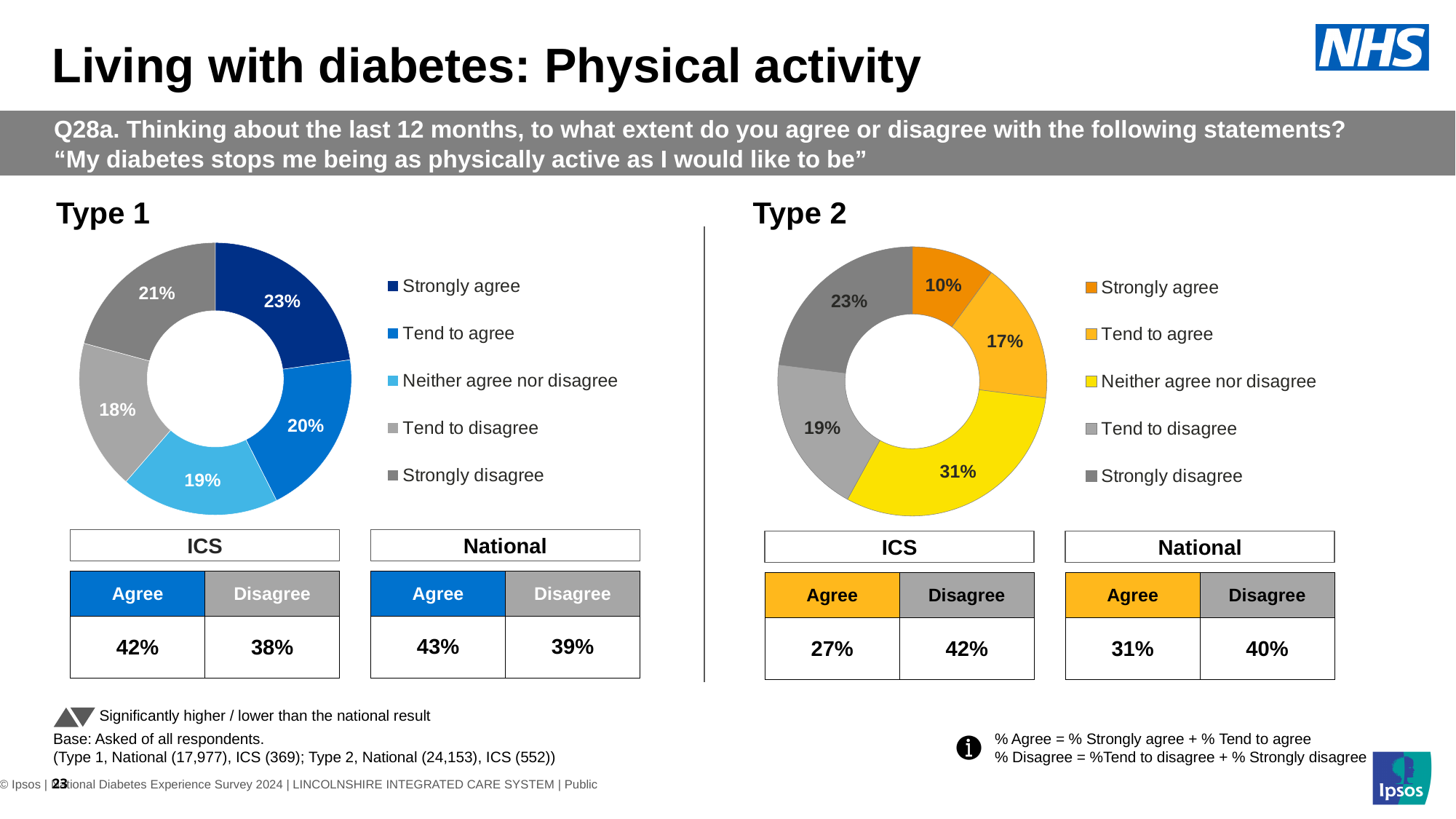
In the Type 1 chart, what percentage of respondents said they strongly agree? 23% In the Type 2 chart, what is the difference in percentage points between Strongly disagree and Strongly agree? 13 percentage points In the Type 2 chart, which response category has the largest share? Neither agree nor disagree In the Type 1 chart, what is the difference in percentage points between Strongly agree and Tend to disagree? 5 percentage points In the Type 2 chart, what percentage of respondents said they neither agree nor disagree? 31% In the Type 1 chart, what percentage of respondents said they tend to disagree? 18% Which is larger: the Strongly agree share in the Type 1 chart or the Strongly agree share in the Type 2 chart? Type 1 In the Type 2 chart, what percentage of respondents said they tend to agree? 17% In the Type 1 chart, which response category has the largest share? Strongly agree What kind of chart is used for the Type 1 results? Donut (pie) chart How many response categories does the legend of the Type 2 chart list? 5 In the Type 2 chart, which response category has the smallest share? Strongly agree